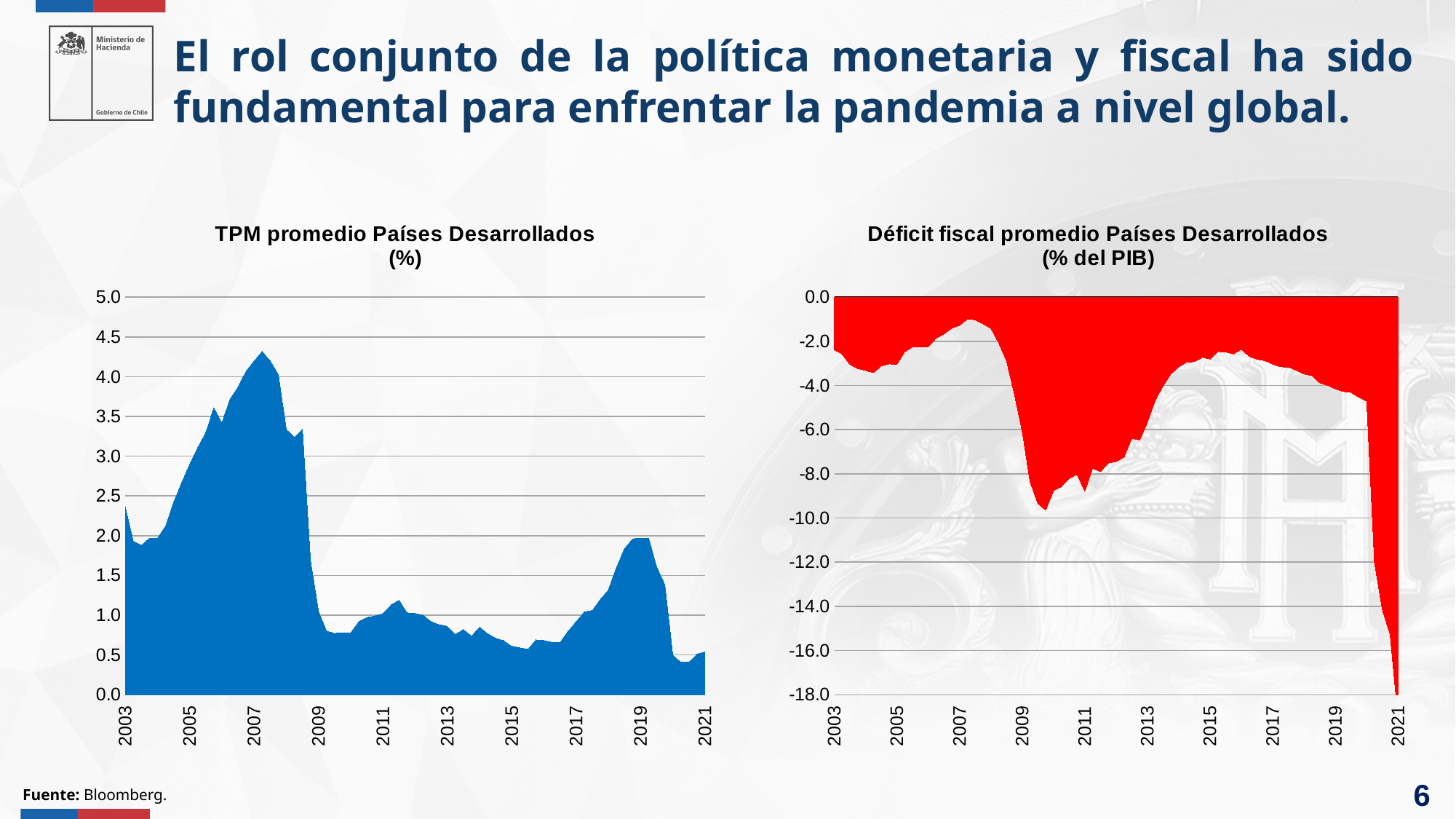
In the left chart (TPM promedio Países Desarrollados), is the value at the start of 2003 greater or less than 2.0? greater In the right chart (Déficit fiscal promedio Países Desarrollados), does the value rise or fall between 2019 and 2021? fall What kind of chart is the 'Déficit fiscal promedio Países Desarrollados (% del PIB)' chart on the right? area chart In the left chart (TPM promedio Países Desarrollados), does the value rise or fall between 2003 and 2007? rise In the left chart (TPM promedio Países Desarrollados), is the value at 2015 greater or less than 1.0? less What kind of chart is the 'TPM promedio Países Desarrollados (%)' chart on the left? area chart In the right chart (Déficit fiscal promedio Países Desarrollados), is the value at the end of 2021 greater or less than -16.0? less In the left chart (TPM promedio Países Desarrollados), does the value rise or fall between 2007 and 2009? fall What colour is the filled area in the right chart (Déficit fiscal promedio Países Desarrollados)? red